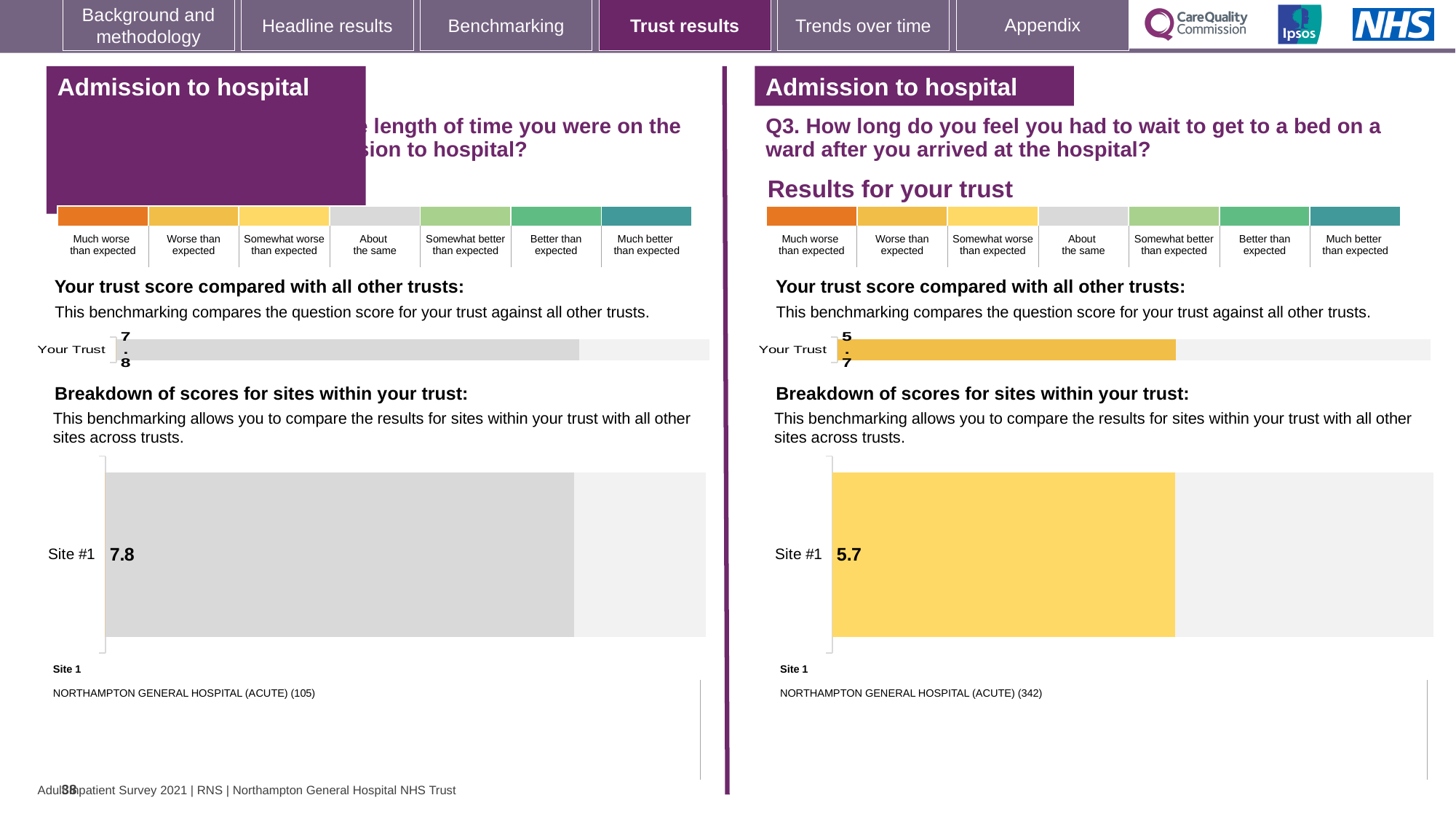
Which is larger: the Your Trust score on the left-hand chart or the Your Trust score on the right-hand Q3 chart? The left-hand chart (7.8) What is the difference between the Site #1 score on the left-hand breakdown chart and the Site #1 score on the right-hand Q3 breakdown chart? 2.1 On the right-hand Q3 breakdown chart, which hospital is listed as Site 1? NORTHAMPTON GENERAL HOSPITAL (ACUTE) (342) On the left-hand 'Your trust score compared with all other trusts' chart, what is the score for Your Trust? 7.8 On the left-hand breakdown chart, which hospital is listed as Site 1? NORTHAMPTON GENERAL HOSPITAL (ACUTE) (105) Which is larger: the Site #1 score on the left-hand breakdown chart or the Site #1 score on the right-hand Q3 breakdown chart? The left-hand chart (7.8) How many sites are shown on the left-hand 'Breakdown of scores for sites within your trust' chart? 1 On the right-hand Q3 'Your trust score compared with all other trusts' chart, what is the score for Your Trust? 5.7 How many sites are shown on the right-hand Q3 'Breakdown of scores for sites within your trust' chart? 1 On the left-hand 'Breakdown of scores for sites within your trust' chart, what is the score for Site #1? 7.8 On the right-hand Q3 'Breakdown of scores for sites within your trust' chart, what is the score for Site #1? 5.7 What kind of chart is the right-hand Q3 'Your trust score compared with all other trusts' chart? Bar chart